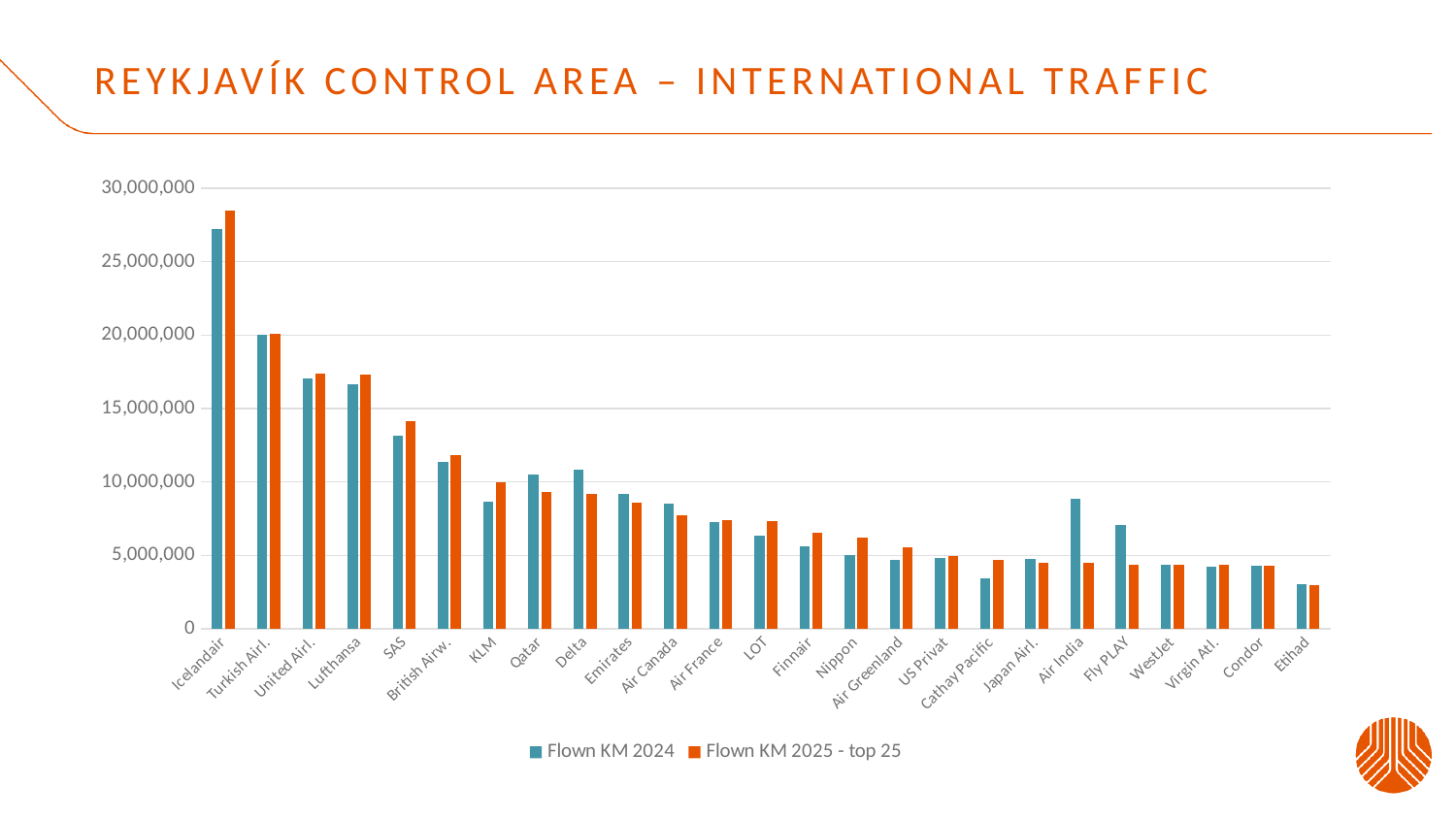
Which airline has the lowest Flown KM 2025 - top 25 value? Etihad Is the Flown KM 2024 value for SAS greater or less than 15,000,000? less How many series does the legend list? 2 Is the Flown KM 2025 - top 25 value for Lufthansa greater or less than 15,000,000? greater Is the Flown KM 2024 value for Air India greater or less than 5,000,000? greater What kind of chart is shown on the slide? bar chart How many airlines/categories are shown on the x axis? 25 For Air India, which is larger: Flown KM 2024 or Flown KM 2025 - top 25? Flown KM 2024 For SAS, which is larger: Flown KM 2024 or Flown KM 2025 - top 25? Flown KM 2025 - top 25 Which airline has the highest Flown KM 2025 - top 25 value? Icelandair Do the Flown KM 2025 - top 25 values generally rise or fall from left to right along the x axis? fall